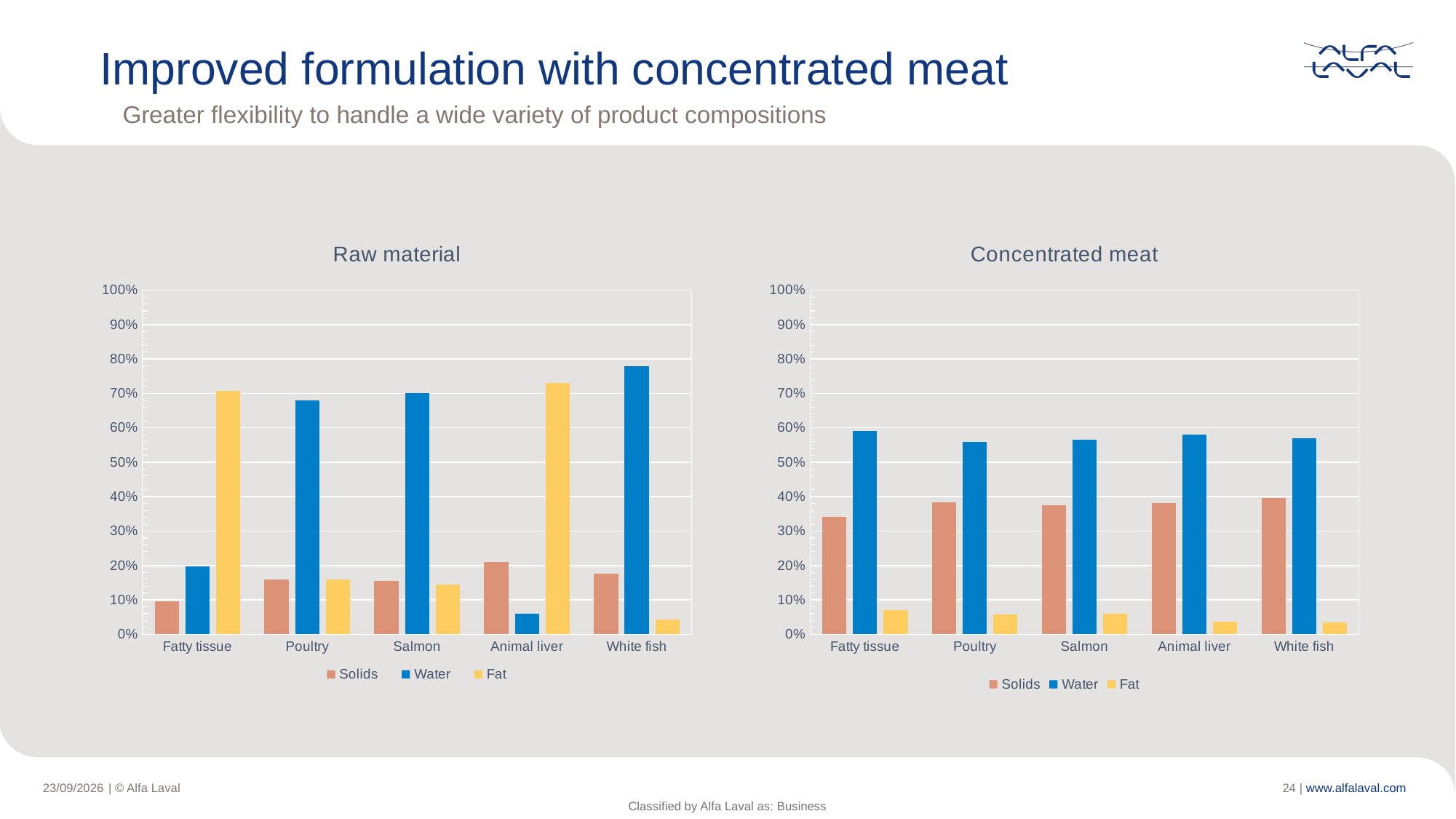
In the Raw material chart, which is larger for Poultry: Water or Fat? Water In the Raw material chart, is the Fat value for Fatty tissue greater or less than 60%? greater In the Raw material chart, is the Water value for Animal liver greater or less than 10%? less In the Concentrated meat chart, is the Fat value for White fish greater or less than 10%? less How many categories are shown on the x axis of the Concentrated meat chart? 5 In the Raw material chart, which category has the highest Water value? White fish In the Raw material chart, which category has the lowest Water value? Animal liver In the Raw material chart, which is larger for Animal liver: Fat or Water? Fat How many series does the legend of the Raw material chart list? 3